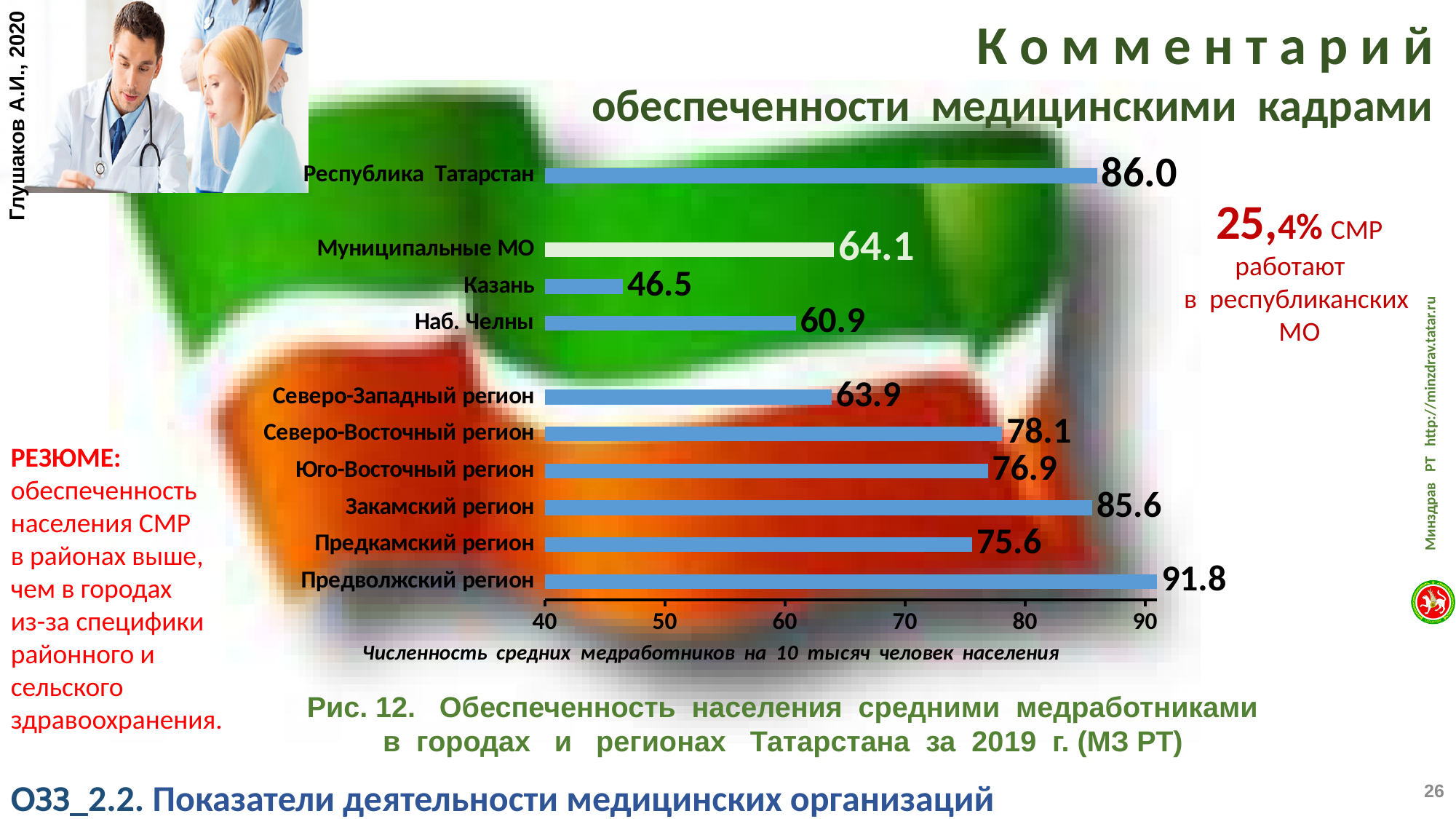
What is the label of the horizontal axis of the chart? Численность средних медработников на 10 тысяч человек населения Is the value for Предкамский регион greater or less than 70? greater What is the value for Республика Татарстан? 86.0 Which is larger, the value for Наб. Челны or the value for Муниципальные МО? Муниципальные МО What kind of chart is shown on the slide? bar chart What is the value for Казань? 46.5 Which category has the lowest value? Казань Which category has the highest value? Предволжский регион How many categories are shown in the chart? 10 What is the value for Закамский регион? 85.6 What is the difference between the values for Предволжский регион and Казань? 45.3 What is the difference between the values for Северо-Восточный регион and Юго-Восточный регион? 1.2